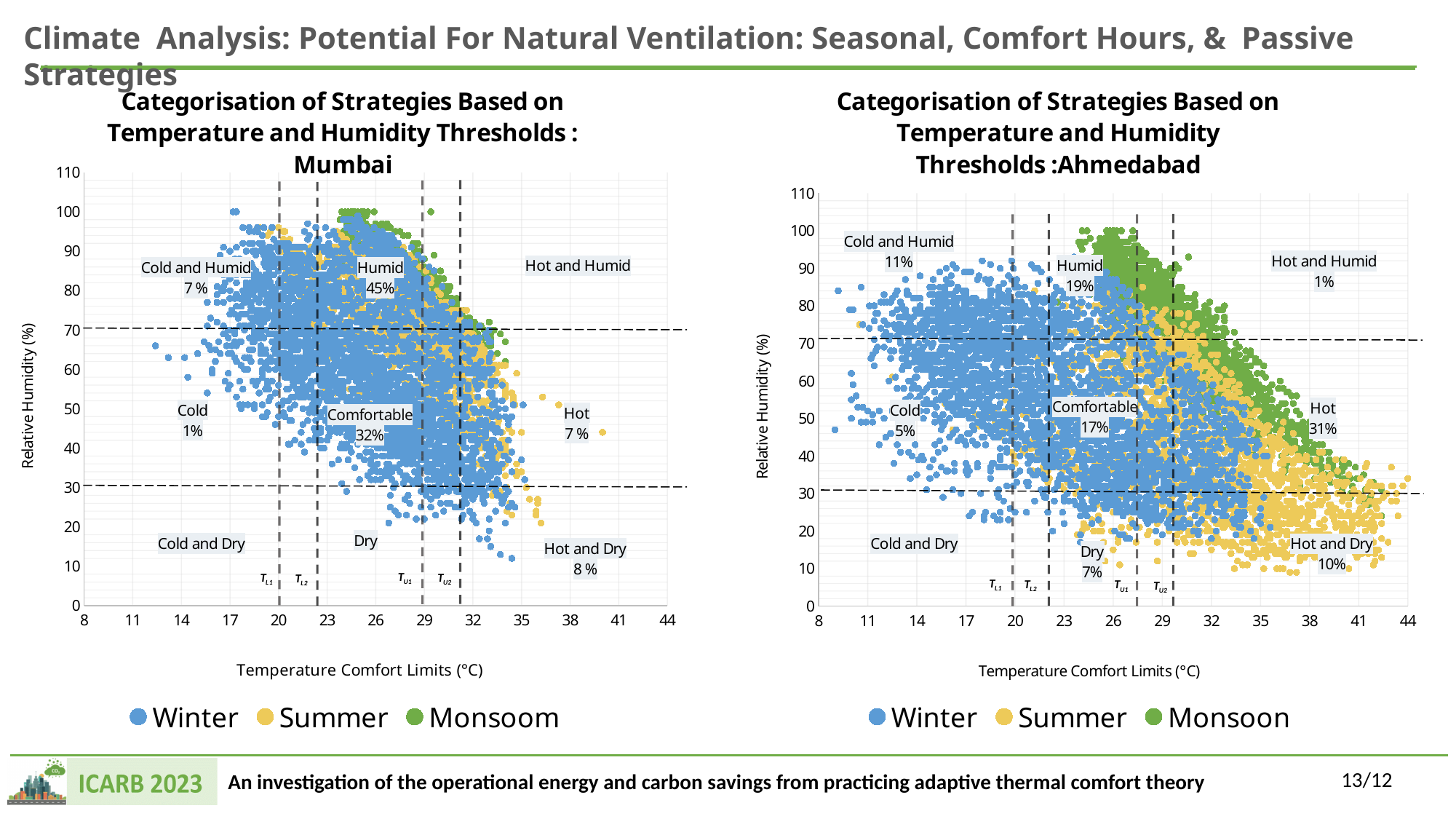
In the Mumbai chart, what percentage is shown for the Humid zone? 45% How many series does the legend of the Ahmedabad chart list? 3 What is the y-axis label of the Mumbai chart? Relative Humidity (%) What kind of chart is the Mumbai chart on the left? scatter chart In the Ahmedabad chart, what is the difference between the Hot percentage and the Hot and Dry percentage? 21% In the Ahmedabad chart, what percentage is shown for the Hot and Humid zone? 1% In the Ahmedabad chart, what percentage is shown for the Hot zone? 31% In the Mumbai chart, what percentage is shown for the Comfortable zone? 32% In the Ahmedabad chart, what percentage is shown for the Comfortable zone? 17% In the Ahmedabad chart, which labelled zone has the highest percentage? Hot Which city has the larger Comfortable percentage, Mumbai or Ahmedabad? Mumbai In the Mumbai chart, which labelled zone has the highest percentage? Humid